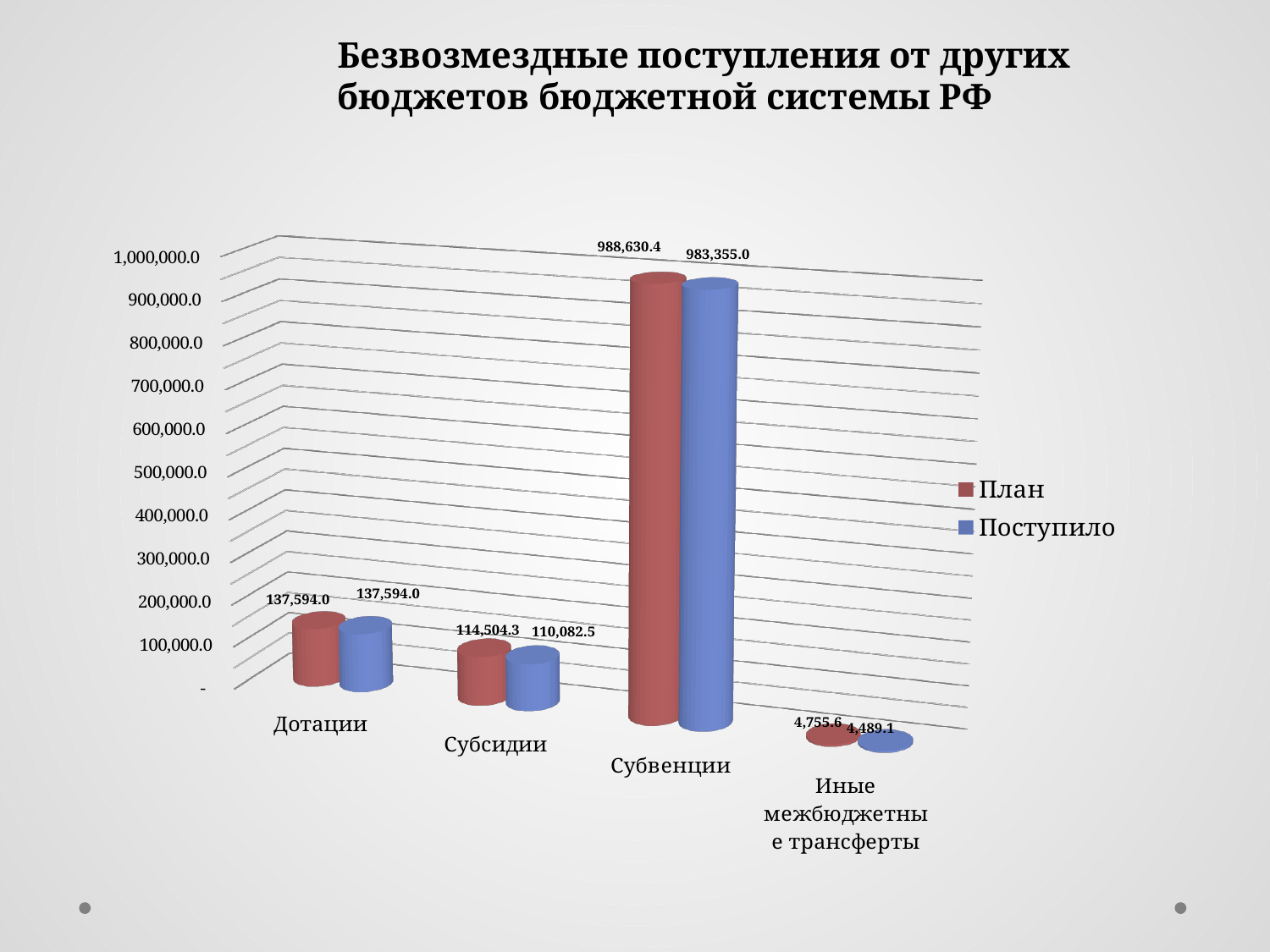
What is the difference between the План and Поступило values for Субсидии? 4,421.8 What is the Поступило value for Субсидии? 110,082.5 How many series does the legend list? 2 Which is larger for Субсидии, the План value or the Поступило value? План Is the Поступило value for Субвенции greater or less than 900,000.0? greater What is the difference between the План and Поступило values for Субвенции? 5,275.4 What kind of chart is shown on the slide? bar chart How many categories are shown on the x axis? 4 Which category has the lowest Поступило value? Иные межбюджетные трансферты What is the План value for Субвенции? 988,630.4 What is the Поступило value for Иные межбюджетные трансферты? 4,489.1 Which category has the highest План value? Субвенции